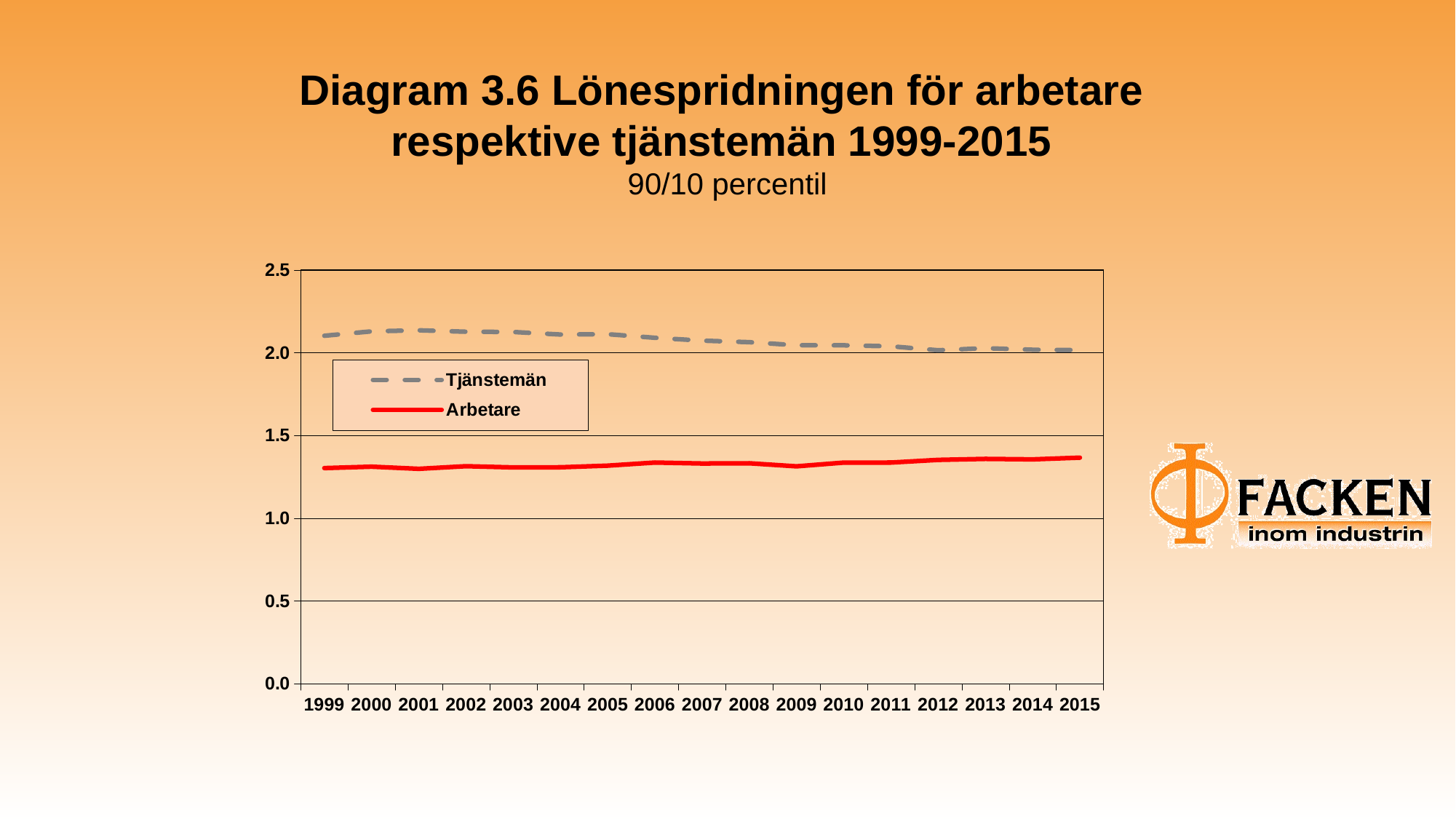
Which series is drawn as a dashed line? Tjänstemän Does the Tjänstemän line rise or fall overall from 1999 to 2015? fall Is the value for Arbetare in 1999 greater or less than 1.0? greater Is the value for Arbetare in 2015 greater or less than 1.5? less Which series is higher in 2015, Tjänstemän or Arbetare? Tjänstemän Is the value for Tjänstemän in 2015 greater or less than 1.5? greater How many years are shown on the x axis? 17 What kind of chart is shown on the slide? line chart Does the Arbetare line rise or fall overall from 1999 to 2015? rise Which series is higher in 1999, Tjänstemän or Arbetare? Tjänstemän How many series does the legend list? 2